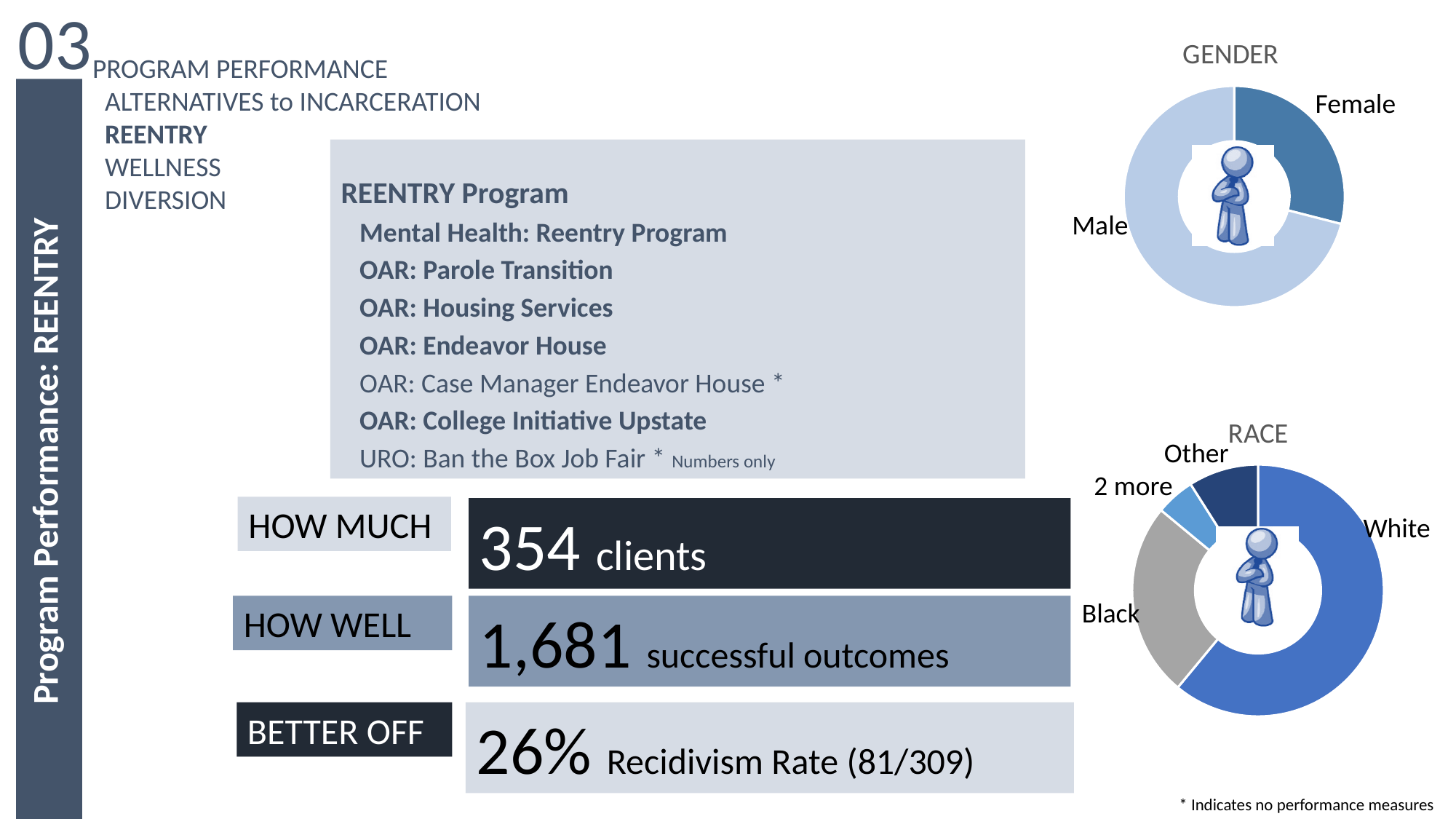
What kind of chart is the GENDER chart? doughnut chart In the GENDER chart, how many categories are shown? 2 In the GENDER chart, which category has the smallest share? Female In the GENDER chart, which category has the largest share? Male What kind of chart is the RACE chart? doughnut chart In the RACE chart, which category has the largest share? White In the GENDER chart, which is larger, Male or Female? Male What is the title of the chart in the top right of the slide? GENDER In the RACE chart, which is larger, Black or Other? Black In the RACE chart, which is larger, White or Black? White What are the category labels shown on the RACE chart? White, Black, 2 more, Other In the RACE chart, how many categories are shown? 4